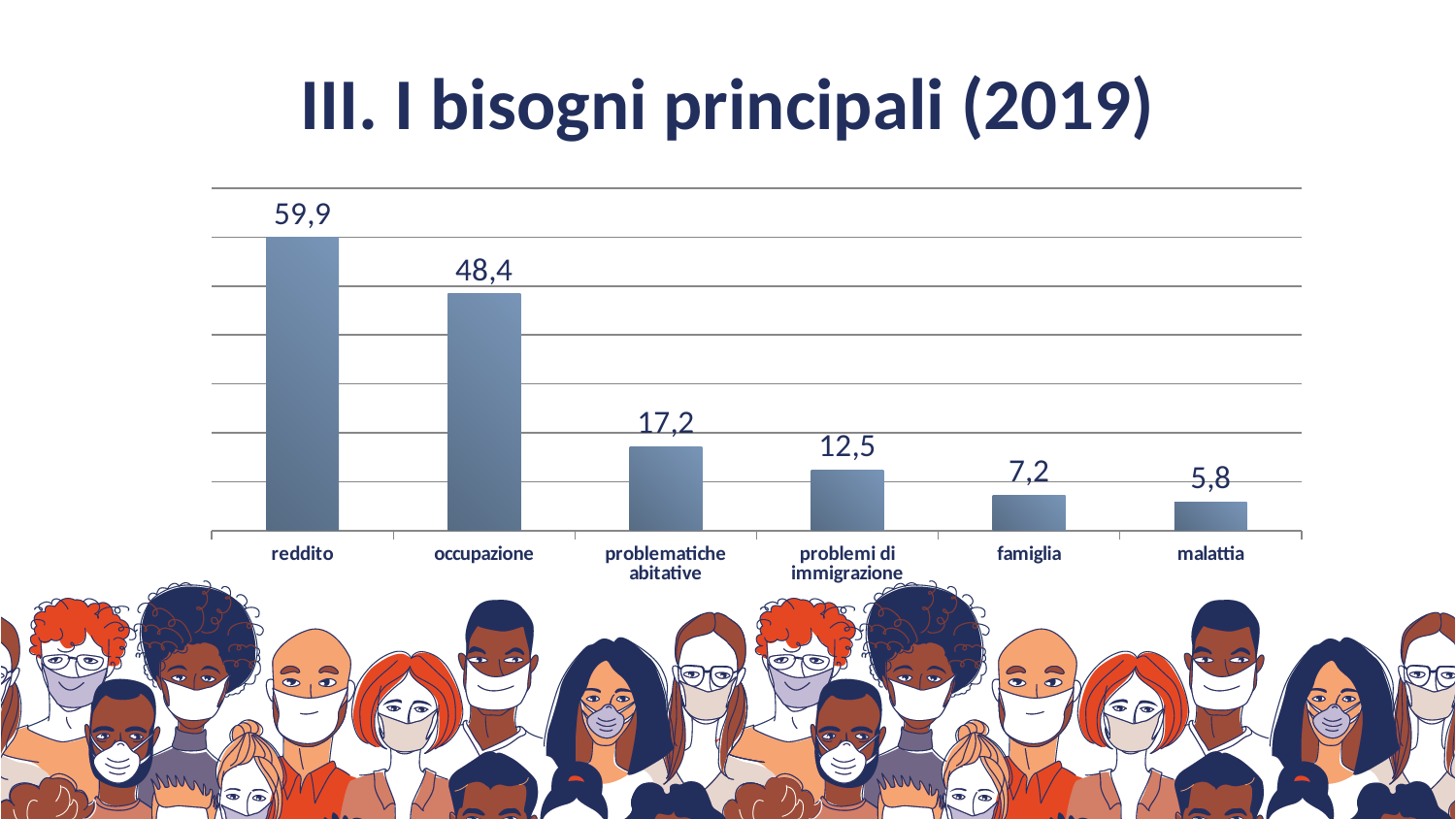
What is the title of the slide? III. I bisogni principali (2019) What kind of chart is shown on the slide? bar chart Which is larger, the value for famiglia or the value for problemi di immigrazione? problemi di immigrazione What is the value for reddito? 59,9 Which category has the lowest value? malattia What is the value for problemi di immigrazione? 12,5 How many categories are shown in the chart? 6 What is the value for occupazione? 48,4 What is the difference between the values for reddito and occupazione? 11,5 Which category has the highest value? reddito What is the value for malattia? 5,8 What is the value for problematiche abitative? 17,2